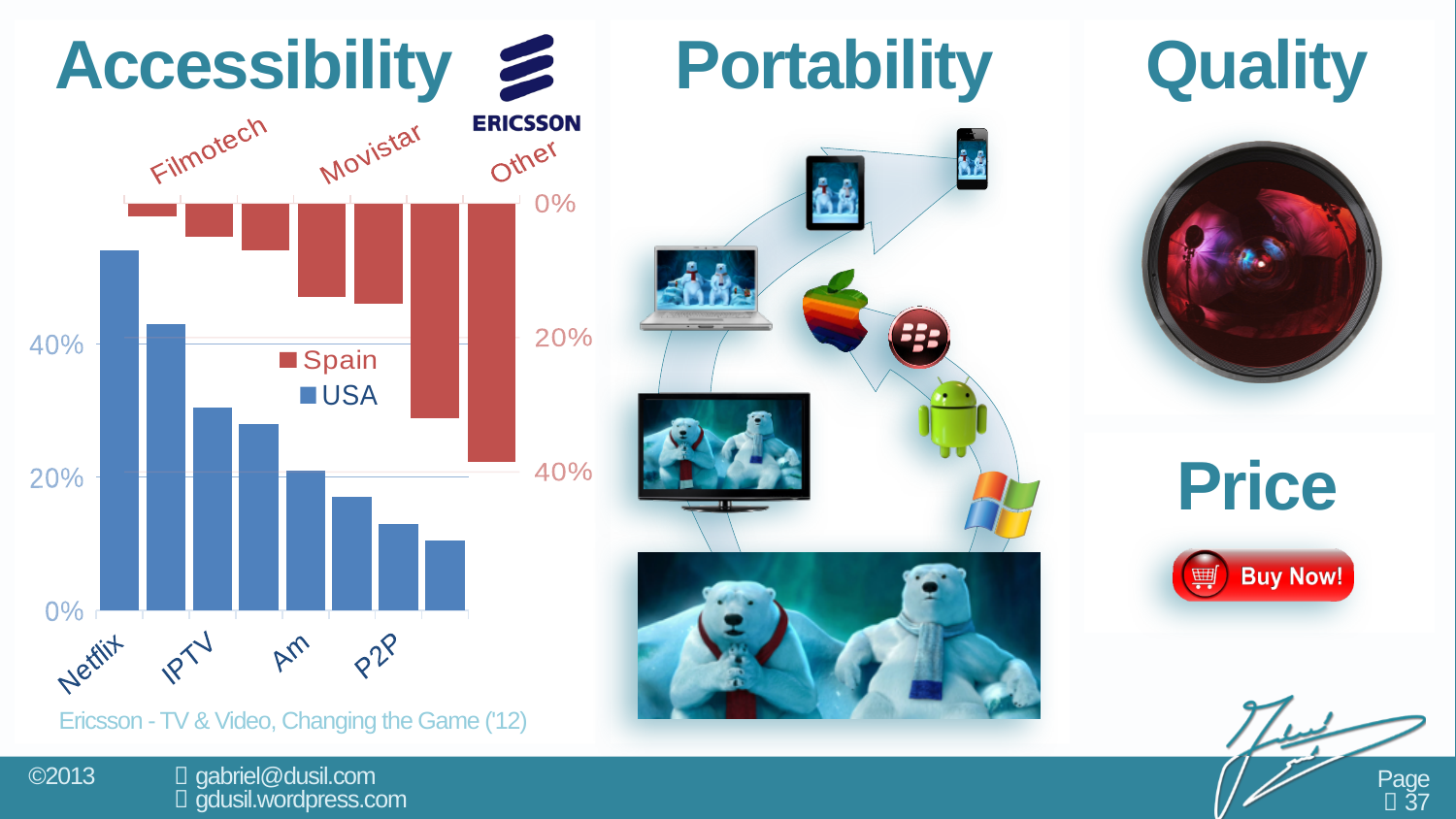
In the Accessibility chart, is the Spain value for Other greater or less than 20%? greater In the Accessibility chart, which labelled category has the highest USA value? Netflix In the Accessibility chart, is the USA value for IPTV greater or less than 40%? less In the Accessibility chart, is the USA value for Netflix greater or less than 40%? greater What kind of chart is shown under the Accessibility heading? bar chart In the Accessibility chart, which is larger for the USA series: Netflix or P2P? Netflix In the Accessibility chart, do the USA bars rise or fall from left to right? fall How many series does the legend of the Accessibility chart list? 2 What are the two series named in the legend of the Accessibility chart? Spain and USA In the Accessibility chart, which is larger for the Spain series: Other or Filmotech? Other